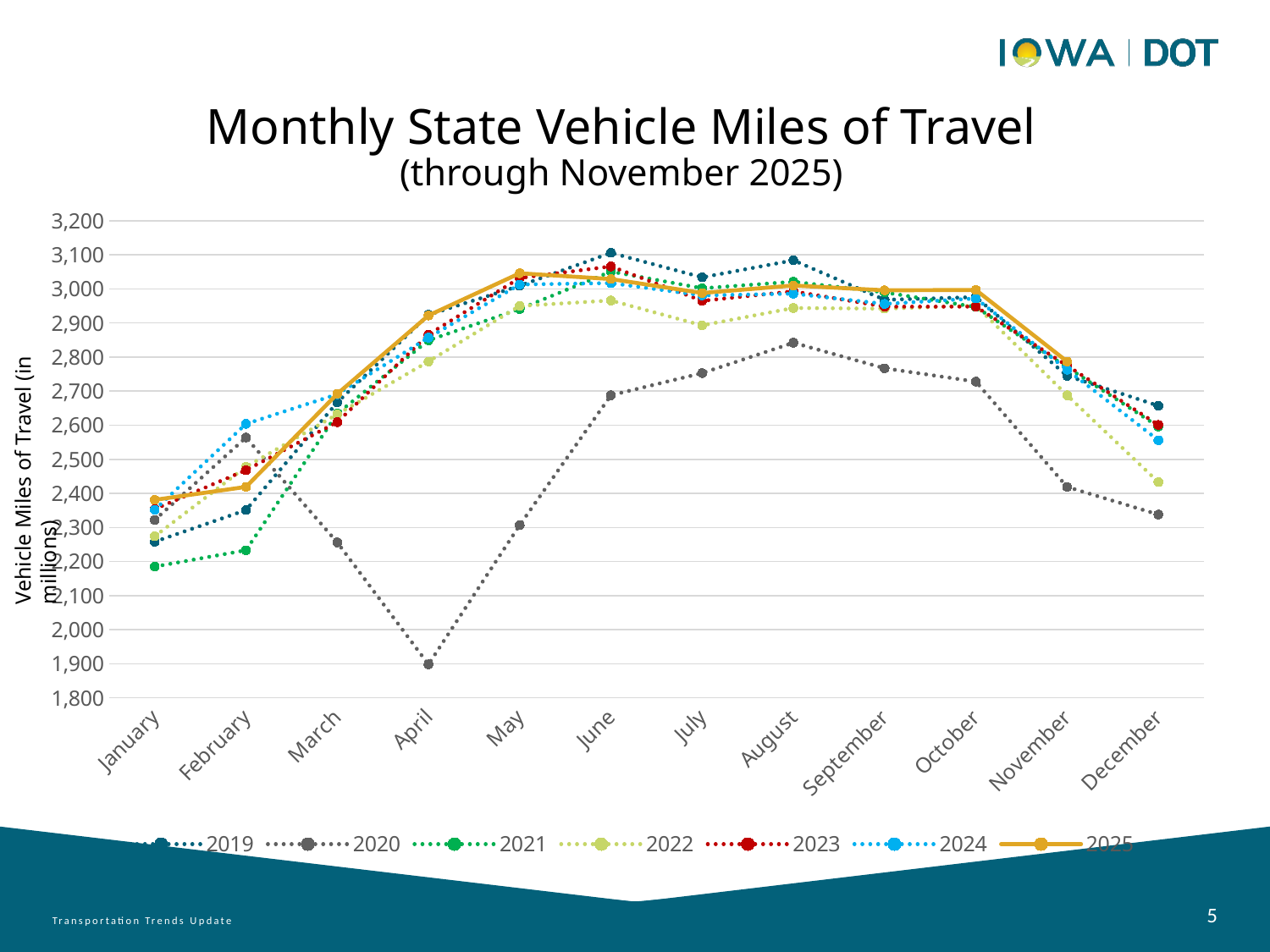
Which year's series is drawn as a solid line rather than a dotted line? 2025 What is the label on the vertical axis? Vehicle Miles of Travel (in millions) Is the value for 2020 in April greater or less than 2,000? less Is the value for 2019 in June greater or less than 3,000? greater What kind of chart is shown on the slide? line chart Which year has the lowest value in April? 2020 Is the value for 2021 in January greater or less than 2,300? less How many series does the legend list? 7 Which is larger in August, the value for 2019 or the value for 2020? 2019 How many months are shown along the x axis? 12 Does the 2025 line rise or fall from January to May? rise